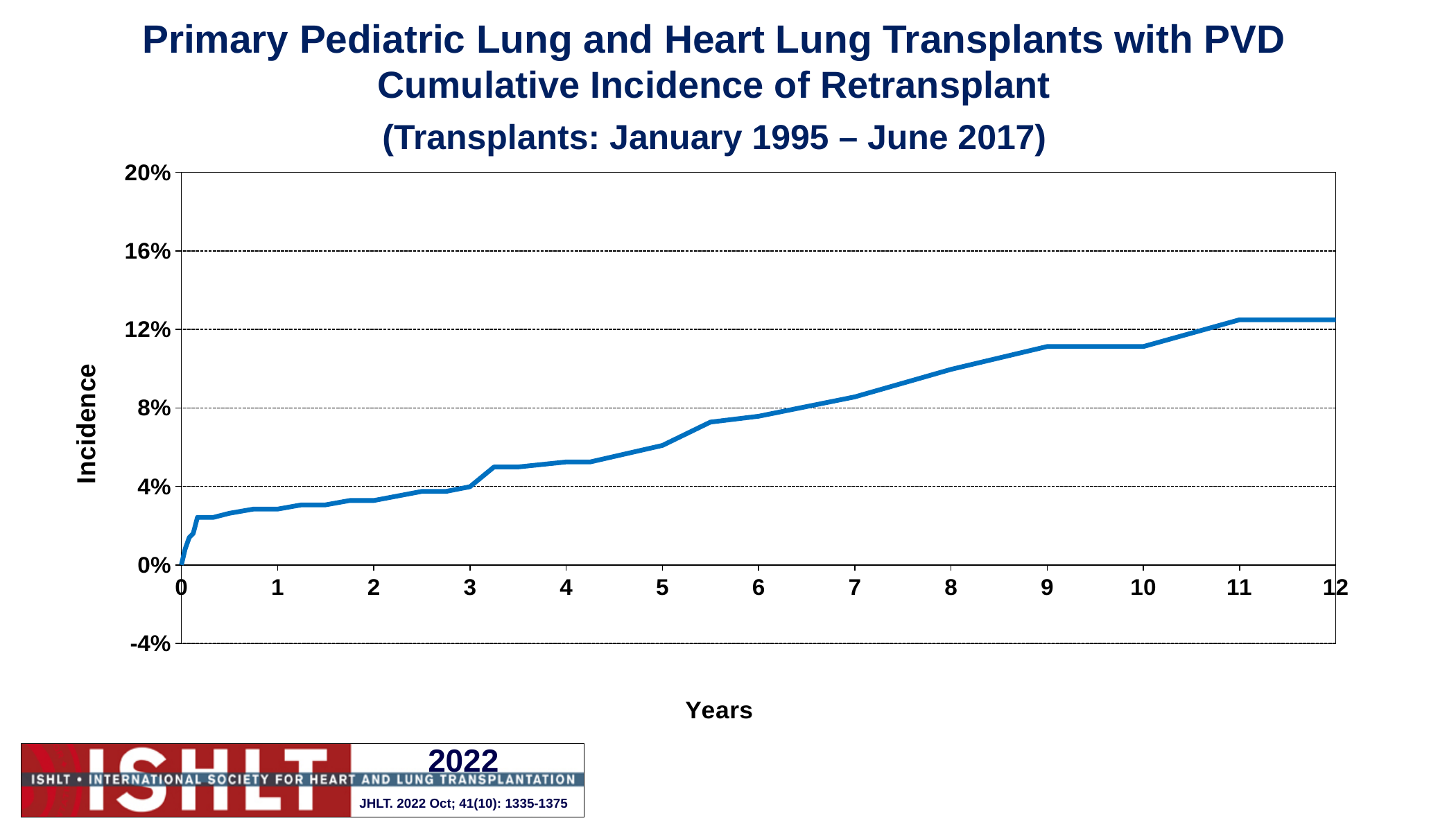
Is the cumulative incidence at year 12 greater or less than 8%? greater Is the cumulative incidence at year 5 greater or less than 8%? less What is the highest value labelled on the y axis? 20% Is the cumulative incidence at year 4 greater or less than 8%? less What is the label of the x axis? Years What kind of chart is shown on the slide? line chart Does the cumulative incidence of retransplant rise or fall as the years increase? rise How many year tick labels are shown on the x axis? 13